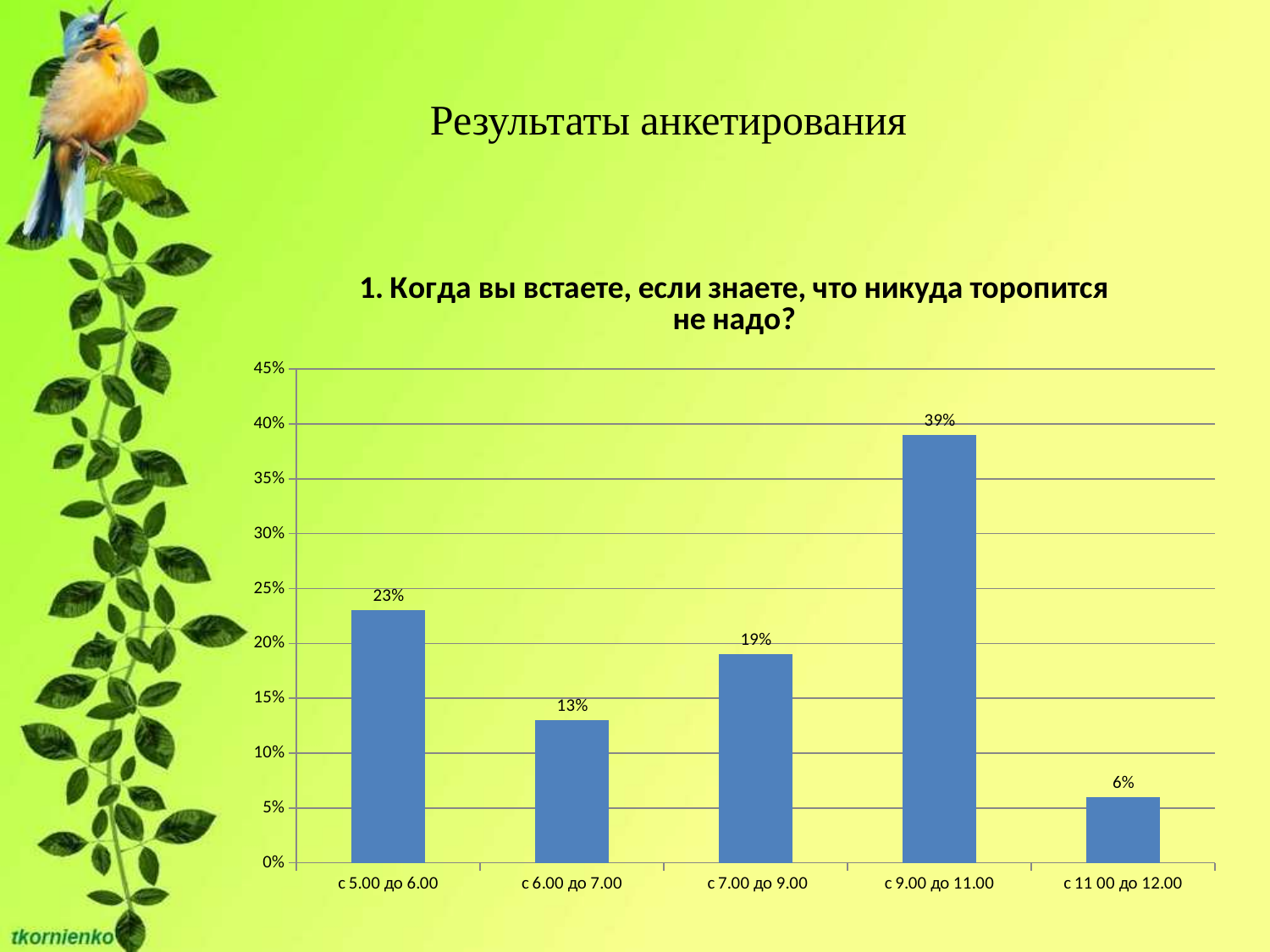
What kind of chart is shown on the slide? bar chart What is the difference between the values for "с 7.00 до 9.00" and "с 6.00 до 7.00"? 6% What is the value for the category "с 5.00 до 6.00"? 23% Which category has the lowest value? с 11 00 до 12.00 Which is larger, the value for "с 5.00 до 6.00" or the value for "с 7.00 до 9.00"? с 5.00 до 6.00 What is the difference between the values for "с 9.00 до 11.00" and "с 5.00 до 6.00"? 16% What is the title of the chart? 1. Когда вы встаете, если знаете, что никуда торопится не надо? What is the value for the category "с 9.00 до 11.00"? 39% Which category has the highest value? с 9.00 до 11.00 Is the value for "с 6.00 до 7.00" greater or less than 15%? less What is the value for the category "с 11 00 до 12.00"? 6% How many categories are shown on the x axis? 5